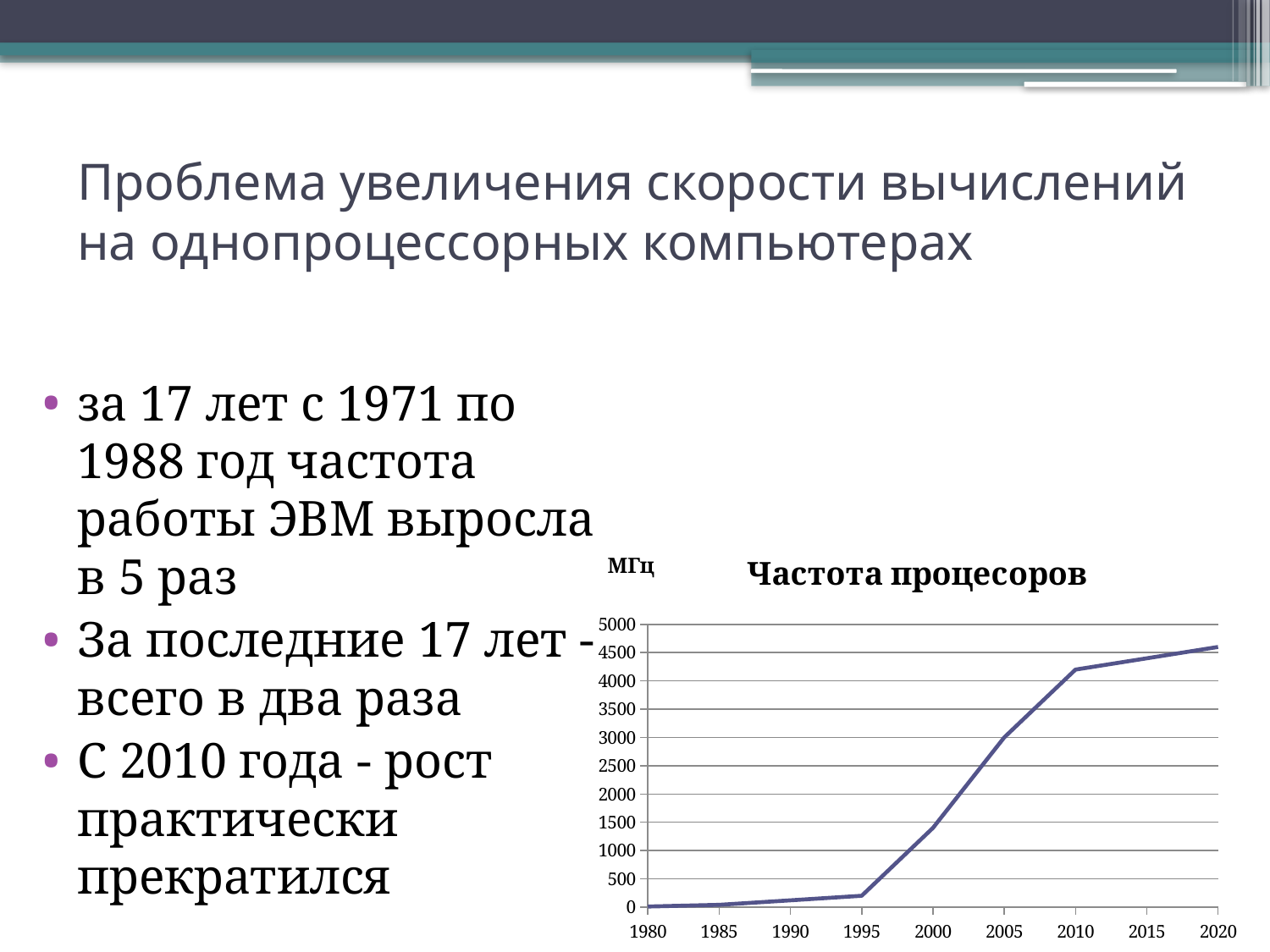
What is the title of the chart? Частота процесоров Which year has the lowest value in the chart? 1980 Is the value for 2000 greater or less than 1000? greater How many years are marked on the x axis of the chart? 9 Is the value for 2010 greater or less than 4000? greater What unit label is shown on the vertical axis of the chart? МГц Which year has the highest value in the chart? 2020 Is the value for 2005 greater or less than 2500? greater What kind of chart is shown on the slide? line chart Do the values in the chart rise or fall as the years increase from 1980 to 2020? rise Which year has the larger value, 2000 or 2005? 2005